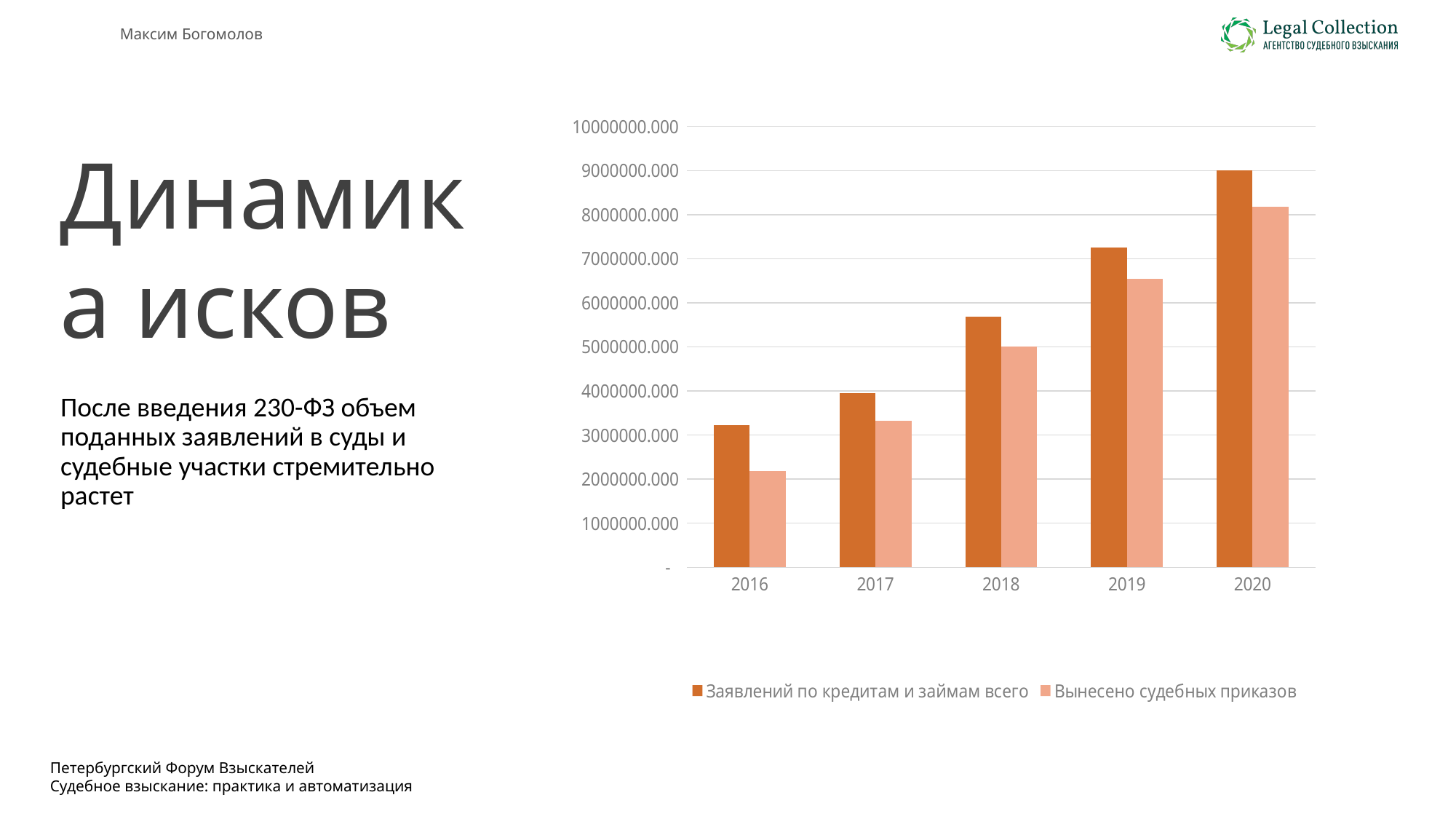
How many series does the legend list? 2 Is the value for 'Заявлений по кредитам и займам всего' in 2018 greater or less than 5000000.000? greater Which year has the lowest value for 'Вынесено судебных приказов'? 2016 Is the value for 'Вынесено судебных приказов' in 2020 greater or less than 8000000.000? greater What kind of chart is shown on the slide? bar chart Do the values for 'Заявлений по кредитам и займам всего' rise or fall from 2016 to 2020? rise How many years are shown on the x axis? 5 Which legend entry is shown in the darker orange colour? Заявлений по кредитам и займам всего Is the value for 'Вынесено судебных приказов' in 2016 greater or less than 3000000.000? less In 2019, which series has the larger value: 'Заявлений по кредитам и займам всего' or 'Вынесено судебных приказов'? Заявлений по кредитам и займам всего Which year has the highest value for 'Заявлений по кредитам и займам всего'? 2020